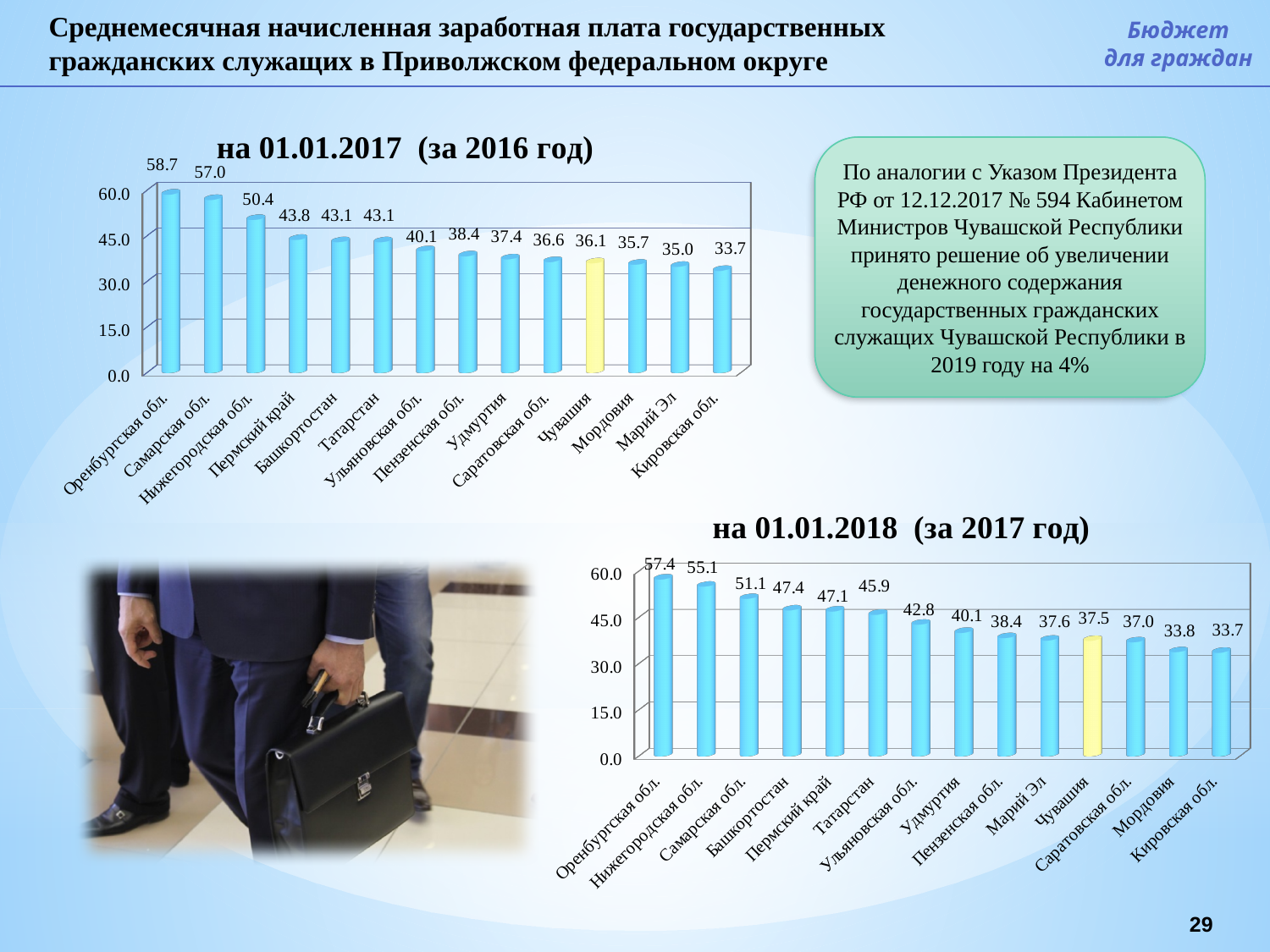
How many regions are shown in the chart 'на 01.01.2017 (за 2016 год)'? 14 In the chart 'на 01.01.2018 (за 2017 год)', what is the difference between the values for Оренбургская обл. and Чувашия? 19.9 In the chart 'на 01.01.2018 (за 2017 год)', do the values rise or fall from left to right? Fall In the chart 'на 01.01.2017 (за 2016 год)', what is the value for Пермский край? 43.8 In the chart 'на 01.01.2018 (за 2017 год)', which is larger: the value for Нижегородская обл. or Самарская обл.? Нижегородская обл. In the chart 'на 01.01.2017 (за 2016 год)', which region has the highest value? Оренбургская обл. In the chart 'на 01.01.2017 (за 2016 год)', what is the difference between the values for Оренбургская обл. and Кировская обл.? 25.0 In the chart 'на 01.01.2017 (за 2016 год)', what is the value for Чувашия? 36.1 In the chart 'на 01.01.2018 (за 2017 год)', what is the value for Татарстан? 45.9 In the chart 'на 01.01.2018 (за 2017 год)', what is the value for Чувашия? 37.5 What type of chart is 'на 01.01.2018 (за 2017 год)'? Bar chart In the chart 'на 01.01.2018 (за 2017 год)', which region has the lowest value? Кировская обл.